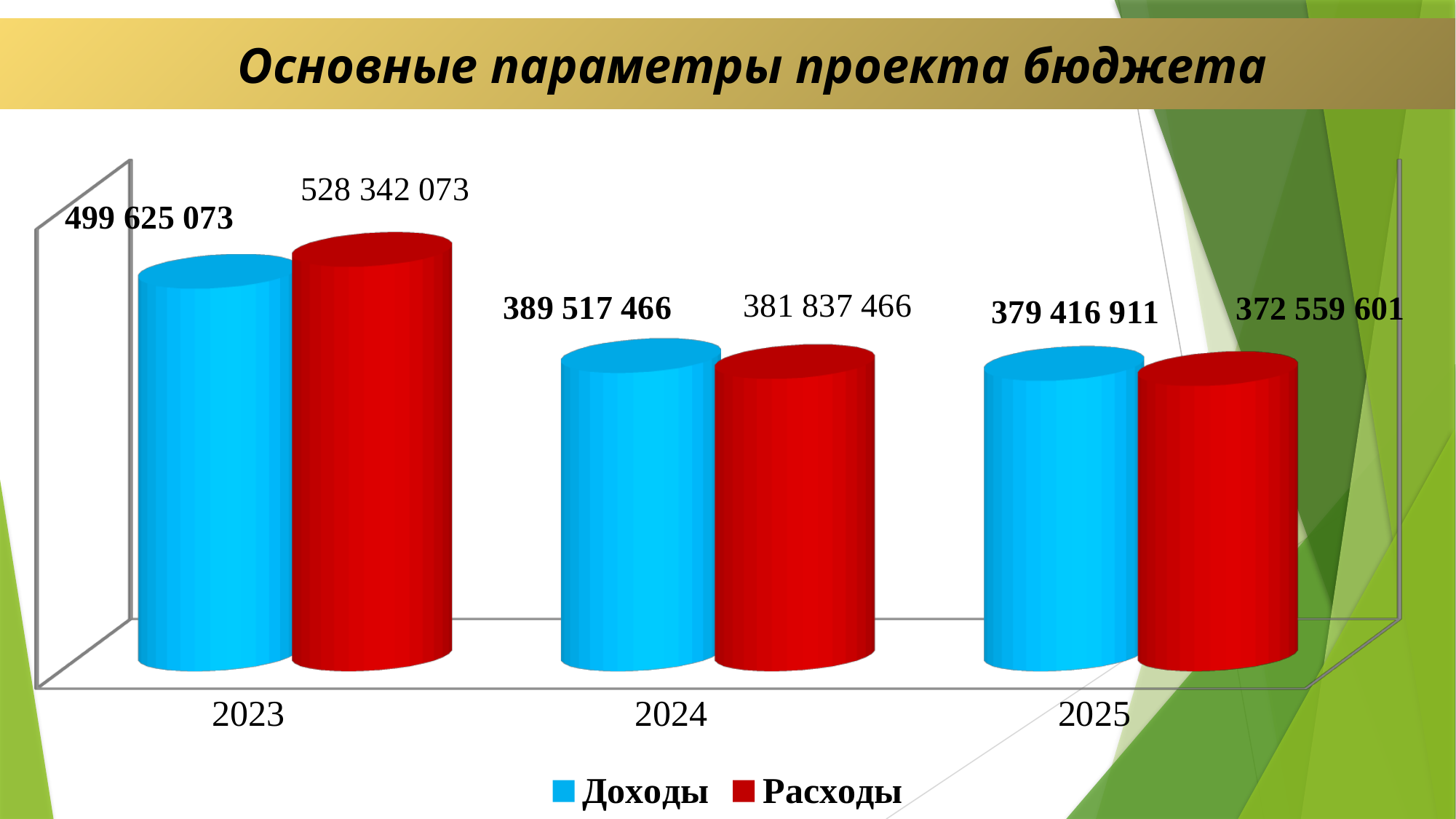
Which is larger in 2023, Доходы or Расходы? Расходы What is the difference between Расходы and Доходы in 2023? 28 717 000 In which year is Доходы the highest? 2023 How many years are shown on the x axis? 3 In which year is Расходы the lowest? 2025 What type of chart is shown on the slide? bar chart What is the difference between Доходы and Расходы in 2024? 7 680 000 What is the value of Доходы for 2023? 499 625 073 What is the value of Расходы for 2024? 381 837 466 Do the Доходы values rise or fall from 2023 to 2025? fall What is the value of Расходы for 2025? 372 559 601 How many series does the legend list? 2